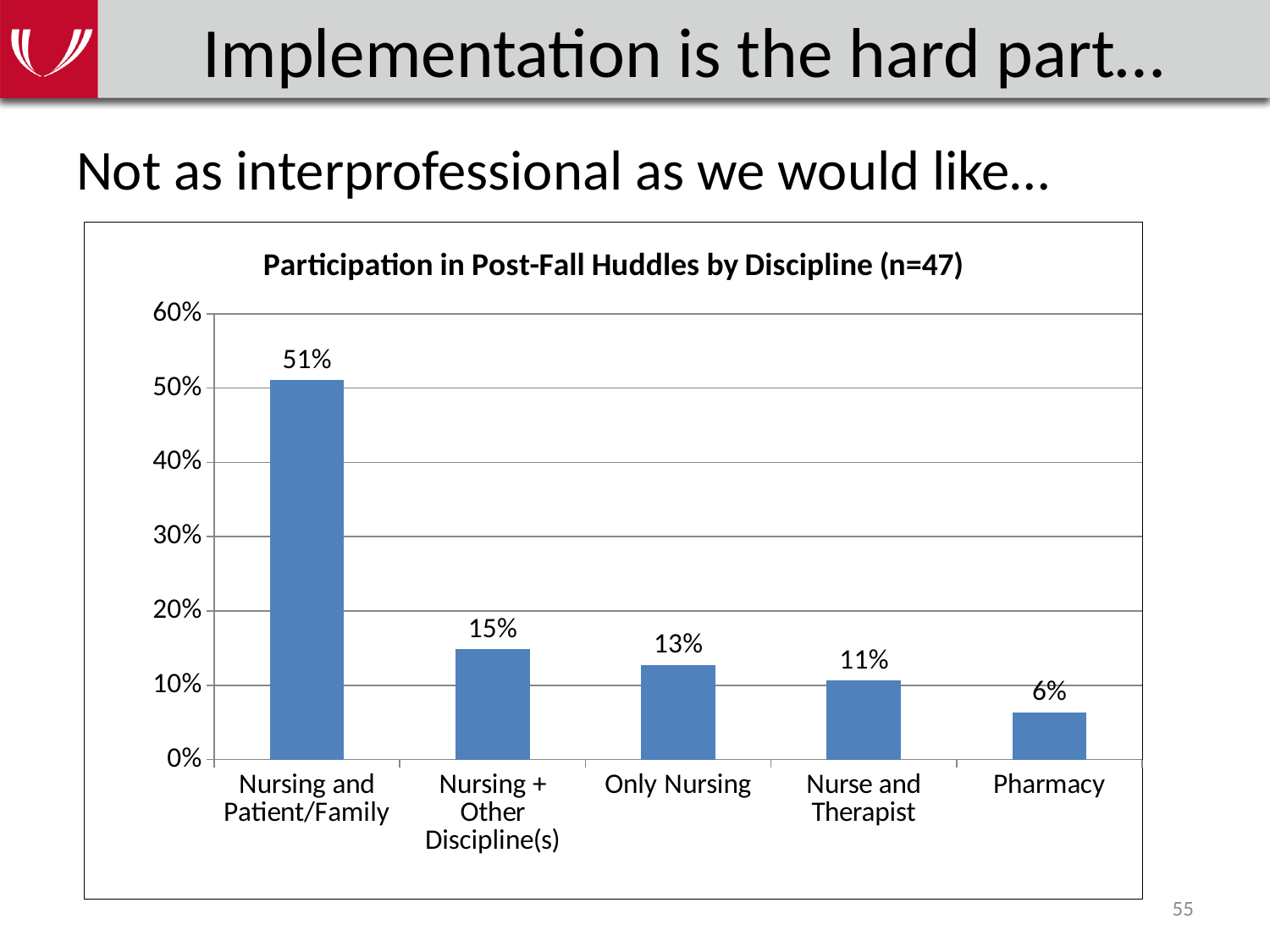
How many categories are shown on the x axis? 5 What is the value for Nurse and Therapist? 11% Which category has the highest participation? Nursing and Patient/Family What kind of chart is shown on the slide? Bar chart What is the value for Only Nursing? 13% What is the value for Pharmacy? 6% What is the title of the chart? Participation in Post-Fall Huddles by Discipline (n=47) What is the value for Nursing + Other Discipline(s)? 15% What is the value for Nursing and Patient/Family? 51% What is the difference between the values for Nursing and Patient/Family and Pharmacy? 45% Which category has the lowest participation? Pharmacy Which is larger, the value for Nursing + Other Discipline(s) or the value for Nurse and Therapist? Nursing + Other Discipline(s)